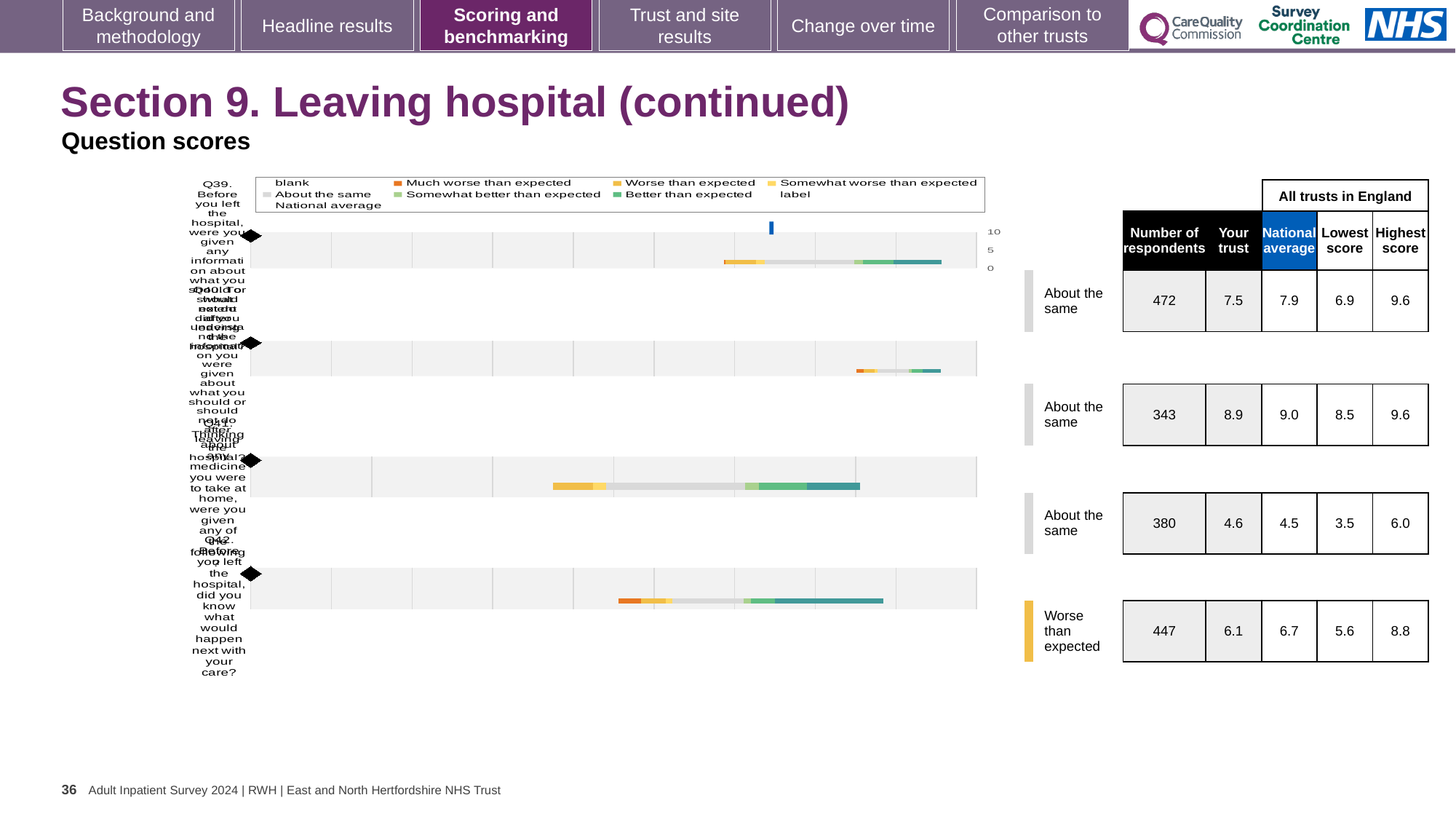
In the table beside the chart, what is the 'Your trust' score for Q39 (the top row)? 7.5 In the table beside the chart, what is the highest score in England for the row rated 'Worse than expected'? 8.8 Which question is plotted in the top bar of the chart? Q39 What kind of chart is shown on the slide? bar chart Which question is plotted in the bottom bar of the chart? Q42 In the table beside the chart, how many respondents are recorded for the row rated 'Worse than expected'? 447 How many question bars are plotted in the chart? 4 For the row rated 'Worse than expected', what is the difference between the national average (6.7) and the trust score (6.1)? 0.6 For Q39 (the top row), which is larger: the trust score or the national average? national average In the table beside the chart, what is the 'Your trust' score for the row rated 'Worse than expected'? 6.1 In the table beside the chart, what is the national average for Q39 (the top row)? 7.9 How many of the four rows in the table are rated 'About the same'? 3